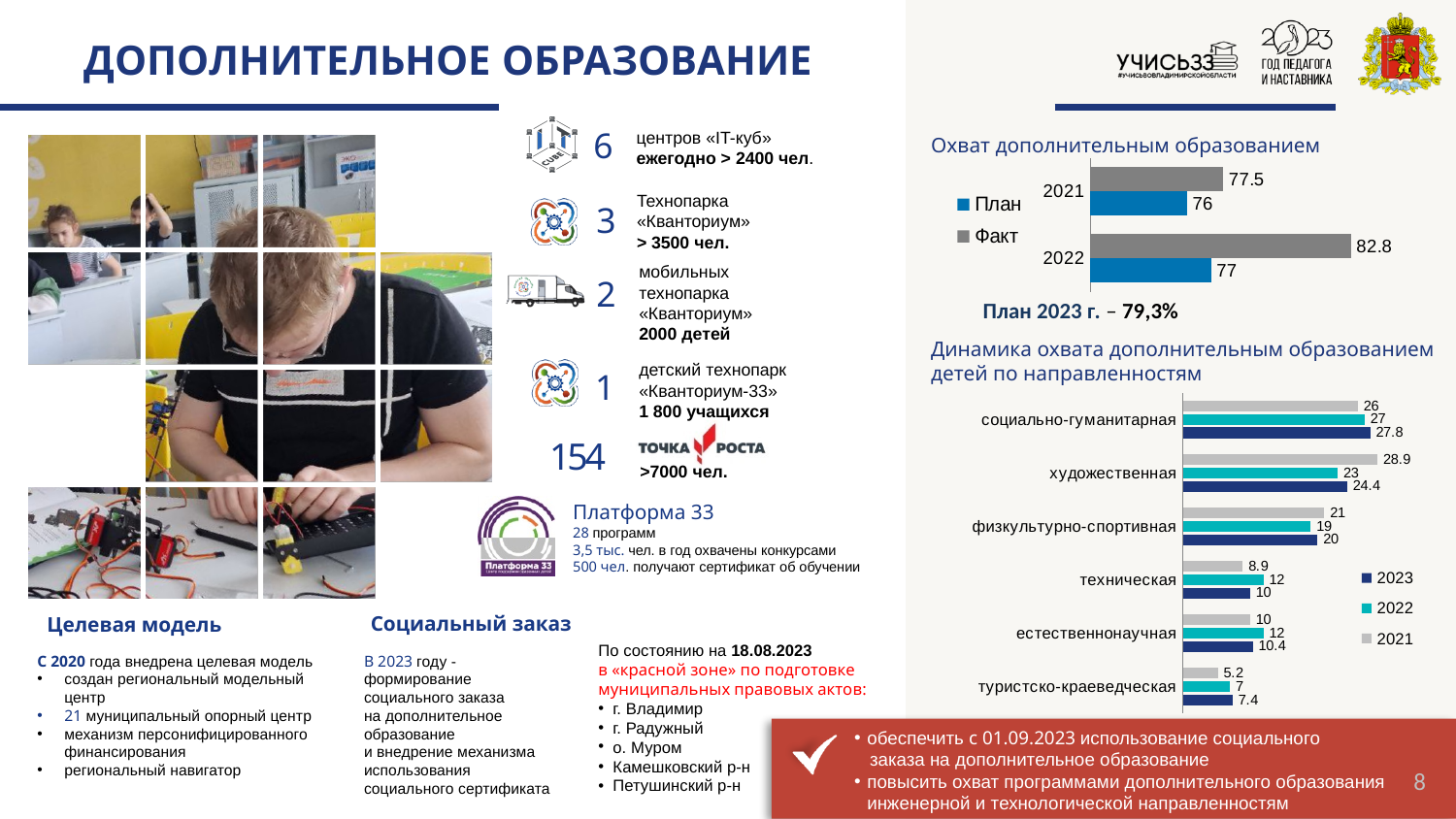
In the chart 'Динамика охвата дополнительным образованием детей по направленностям', what is the 2021 value for художественная? 28.9 In the chart 'Охват дополнительным образованием', what is the План value for 2021? 76 What type of chart is 'Динамика охвата дополнительным образованием детей по направленностям'? bar chart In the chart 'Динамика охвата дополнительным образованием детей по направленностям', what is the 2023 value for туристско-краеведческая? 7.4 In the chart 'Динамика охвата дополнительным образованием детей по направленностям', what is the difference between the 2022 and 2021 values for техническая? 3.1 In the chart 'Динамика охвата дополнительным образованием детей по направленностям', which category has the lowest 2021 value? туристско-краеведческая In the chart 'Охват дополнительным образованием', what is the Факт value for 2022? 82.8 In the chart 'Динамика охвата дополнительным образованием детей по направленностям', which category has the highest 2023 value? социально-гуманитарная In the chart 'Охват дополнительным образованием', what is the difference between the Факт and План values for 2022? 5.8 In the chart 'Охват дополнительным образованием', which is larger for 2021: План or Факт? Факт In the chart 'Динамика охвата дополнительным образованием детей по направленностям', how many categories are shown? 6 In the chart 'Охват дополнительным образованием', how many series does the legend list? 2